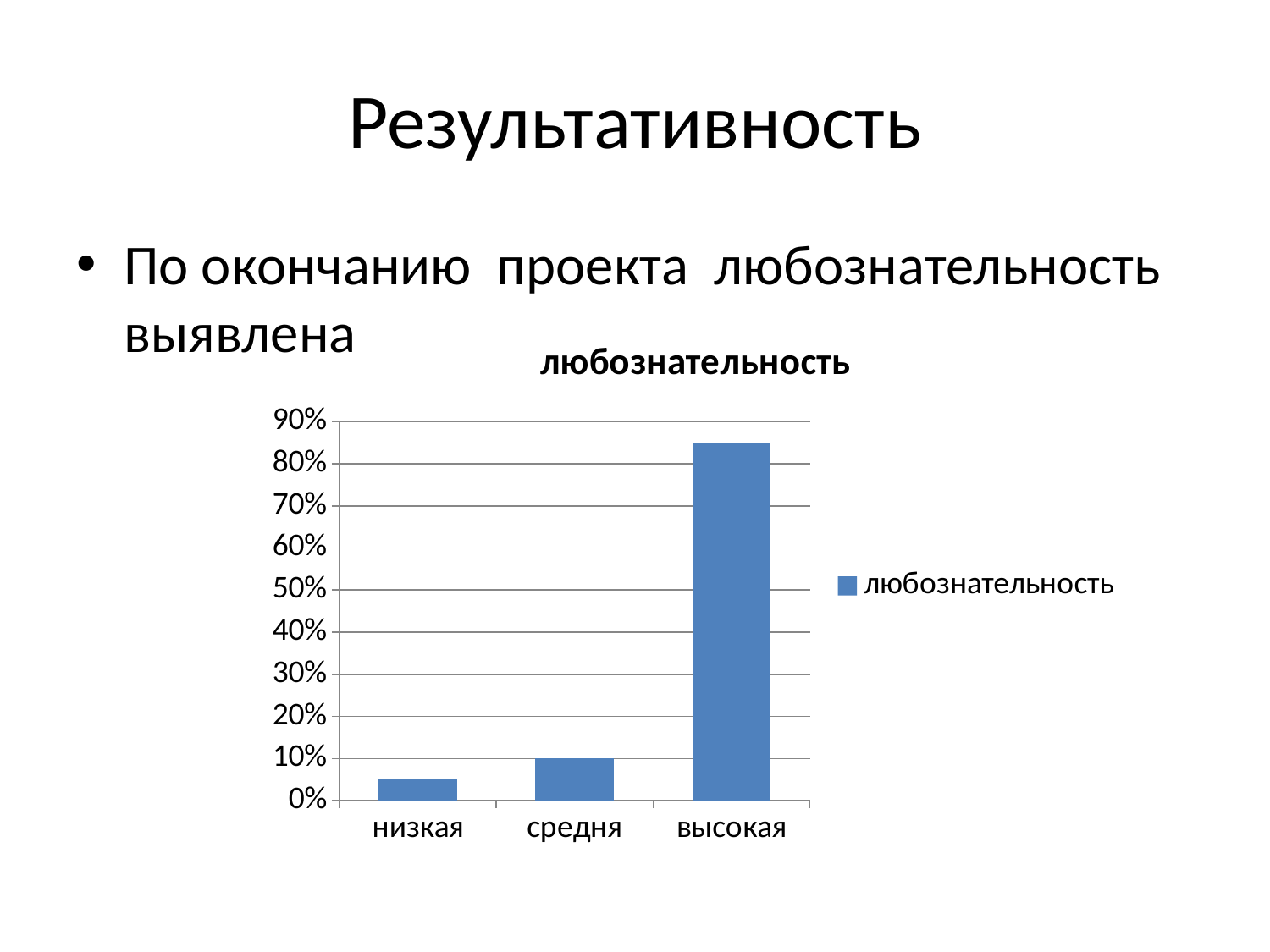
What is the title of the chart? любознательность Which category has the lowest value in the chart? низкая Is the value for низкая greater or less than 10%? less Is the value for высокая greater or less than 80%? greater What type of chart is shown on the slide? bar chart How many series does the chart legend list? 1 Do the values rise or fall from низкая to высокая along the x axis? rise Which is larger, the value for высокая or the value for средня? высокая What is the value for средня in the chart? 10% Which category has the highest value in the chart? высокая How many categories are shown on the x axis of the chart? 3 What is the name of the series shown in the chart legend? любознательность